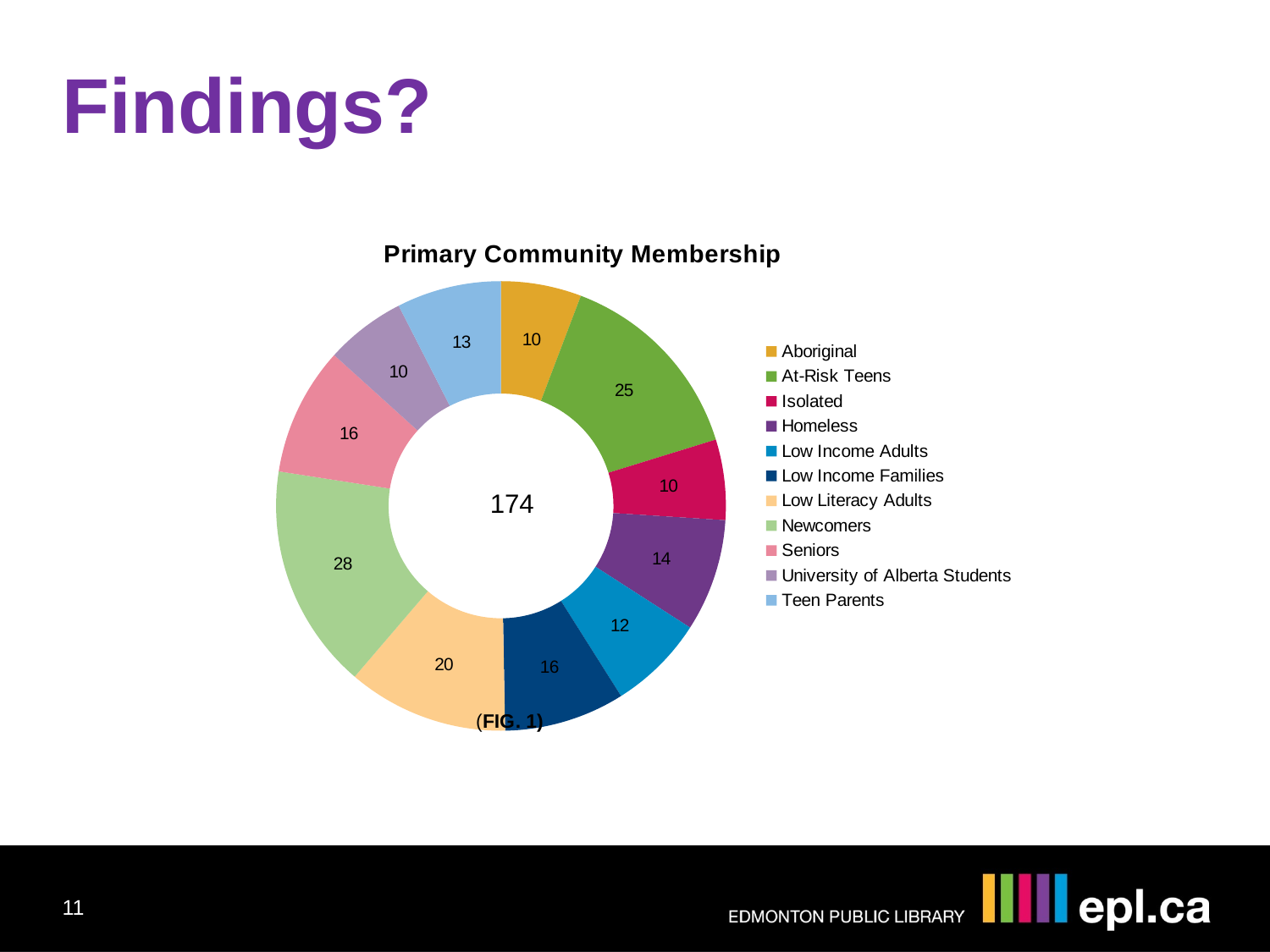
Which is larger, the value for Low Income Families or the value for Low Income Adults? Low Income Families How many categories does the legend list? 11 What is the title of the chart? Primary Community Membership What is the difference between the values for Newcomers and At-Risk Teens? 3 Which community has the highest value? Newcomers What is the value for Newcomers? 28 What is the value for Homeless? 14 What type of chart is shown on the slide? Doughnut chart What total is shown in the centre of the doughnut? 174 What is the value for At-Risk Teens? 25 What is the value for Teen Parents? 13 What is the value for Low Literacy Adults? 20